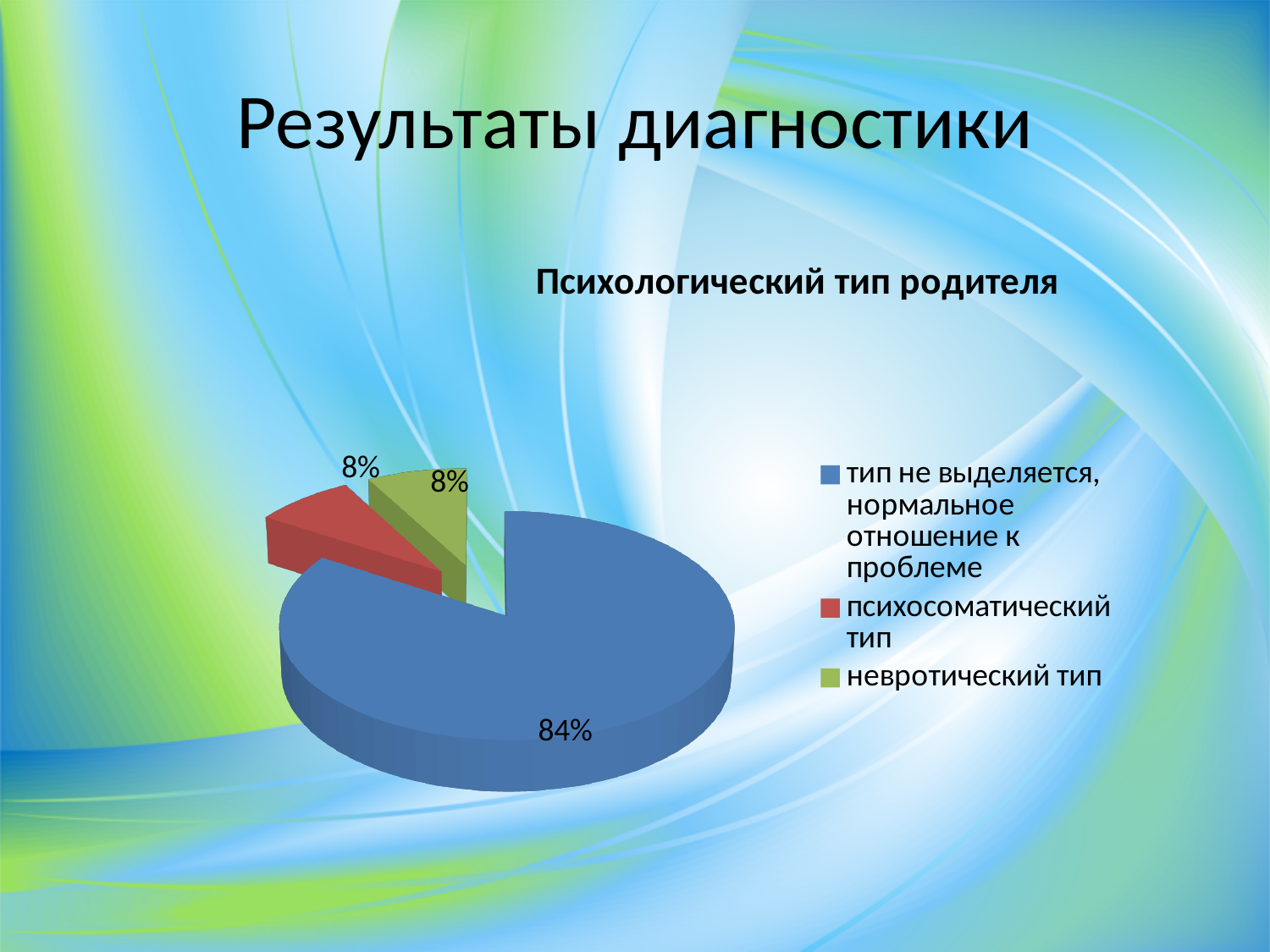
How many entries does the legend list? 3 What is the combined share of "психосоматический тип" and "невротический тип"? 16% Which is larger: the share for "тип не выделяется, нормальное отношение к проблеме" or the share for "невротический тип"? тип не выделяется, нормальное отношение к проблеме What is the difference between the share for "тип не выделяется, нормальное отношение к проблеме" and the share for "психосоматический тип"? 76% What colour is the slice for "психосоматический тип"? red What is the title of the chart? Психологический тип родителя Which category has the largest slice of the pie? тип не выделяется, нормальное отношение к проблеме What share of the pie is labelled "тип не выделяется, нормальное отношение к проблеме"? 84% What share of the pie is labelled "невротический тип"? 8% What share of the pie is labelled "психосоматический тип"? 8% What kind of chart is shown on the slide? pie chart How many slices does the pie chart have? 3